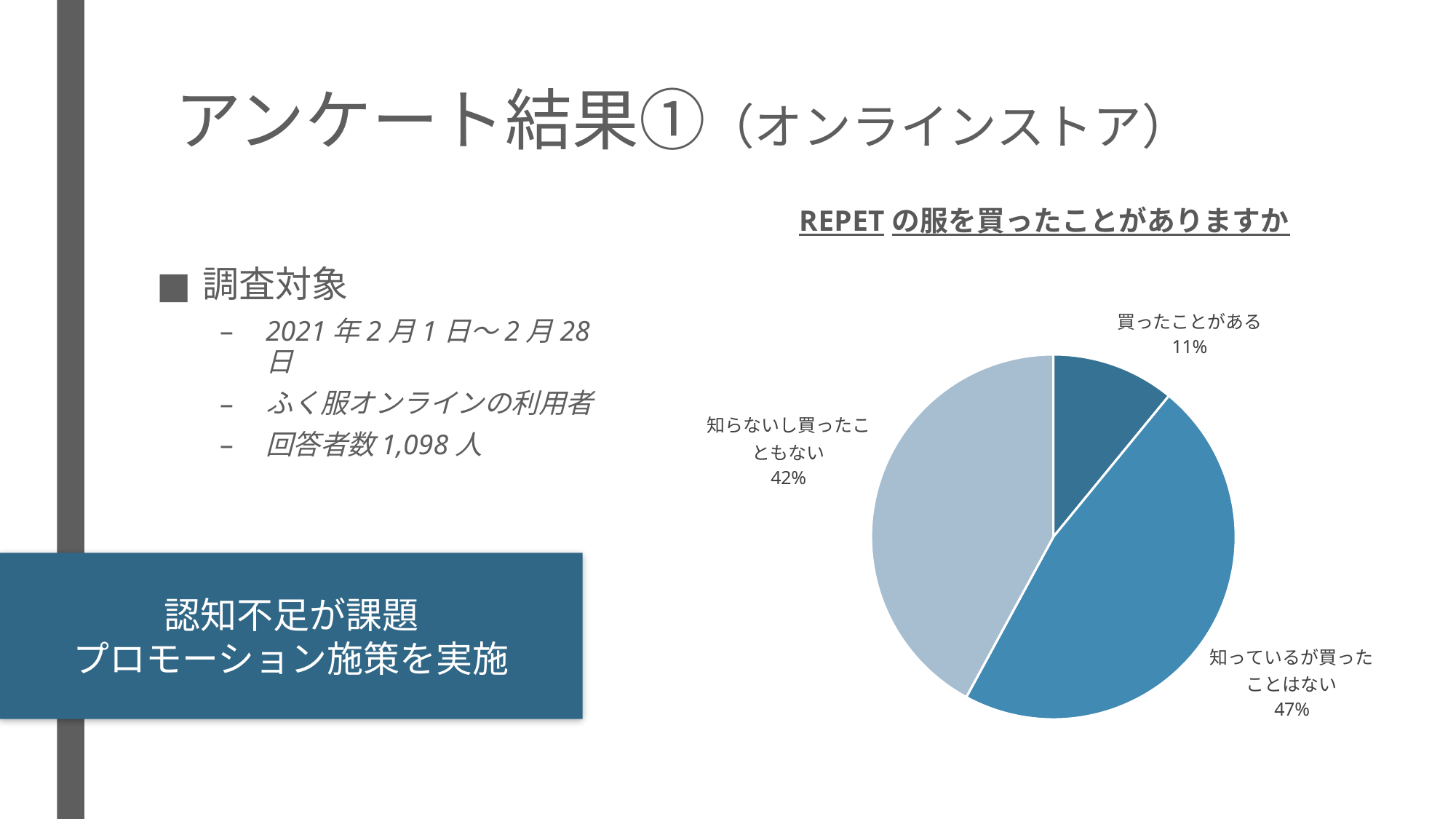
What share of the pie is labelled 知っているが買ったことはない? 47% Which slice of the pie is the smallest? 買ったことがある What is the difference in percentage points between 知っているが買ったことはない and 知らないし買ったこともない? 5% What share of the pie is labelled 買ったことがある? 11% What is the difference in percentage points between 知らないし買ったこともない and 買ったことがある? 31% Which is larger, the slice for 買ったことがある or the slice for 知らないし買ったこともない? 知らないし買ったこともない Which slice of the pie is the largest? 知っているが買ったことはない What share of the pie is labelled 知らないし買ったこともない? 42% What is the title of the pie chart? REPET の服を買ったことがありますか How many slices does the pie chart have? 3 What kind of chart is shown on the slide? pie chart Which slice of the pie is drawn in the lightest colour? 知らないし買ったこともない